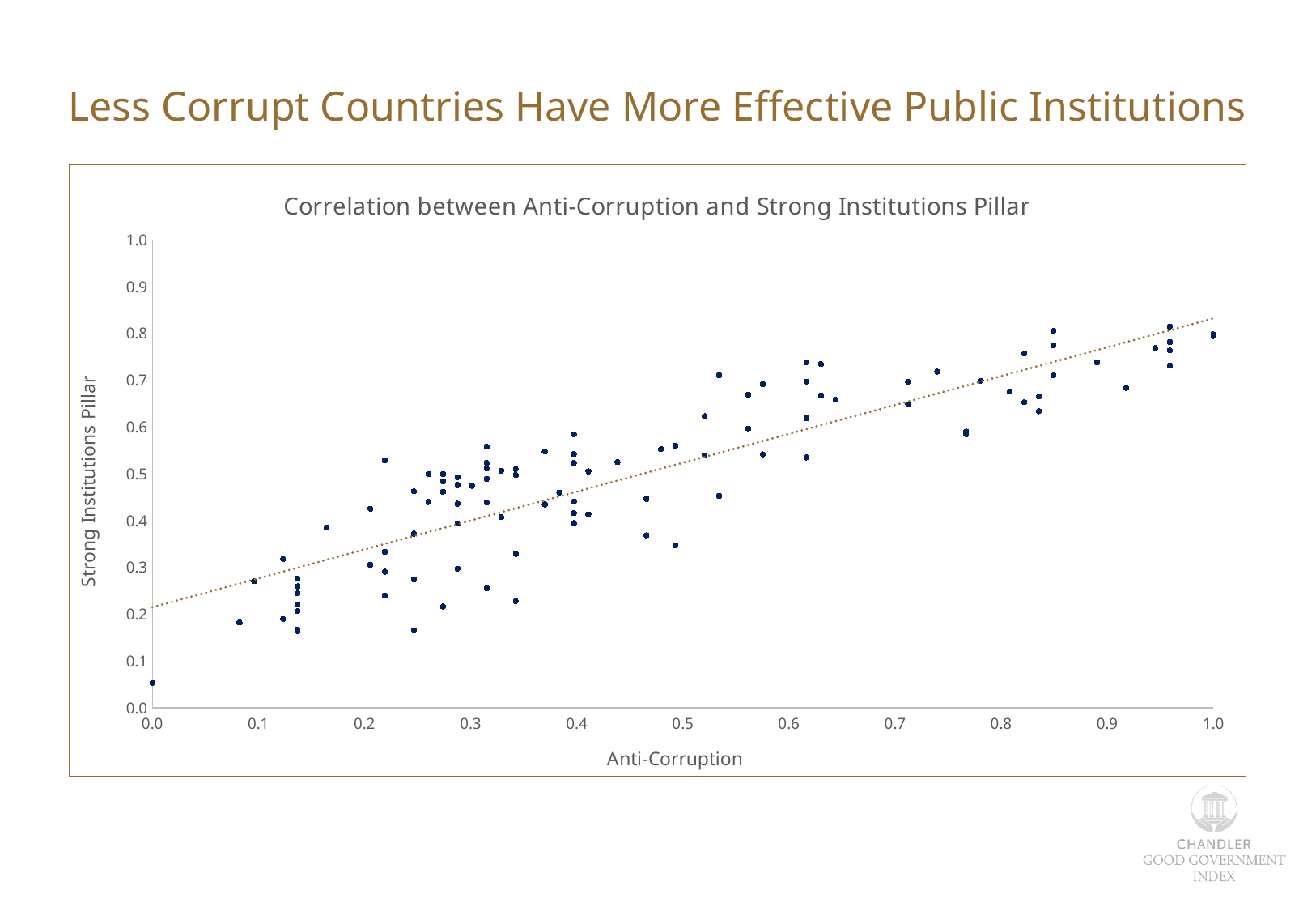
Do the Strong Institutions Pillar values generally rise or fall as Anti-Corruption increases along the x axis? Rise What is the maximum value shown on the y axis? 1.0 Is the Strong Institutions Pillar value for the point at Anti-Corruption 1.0 greater or less than 0.7? greater What is the label of the x axis? Anti-Corruption What is the maximum value shown on the x axis? 1.0 What is the label of the y axis? Strong Institutions Pillar Does the dotted trend line slope upward or downward from left to right? Upward What kind of chart is shown on the slide? Scatter plot Is the Strong Institutions Pillar value for the point at Anti-Corruption 0.0 greater or less than 0.1? less